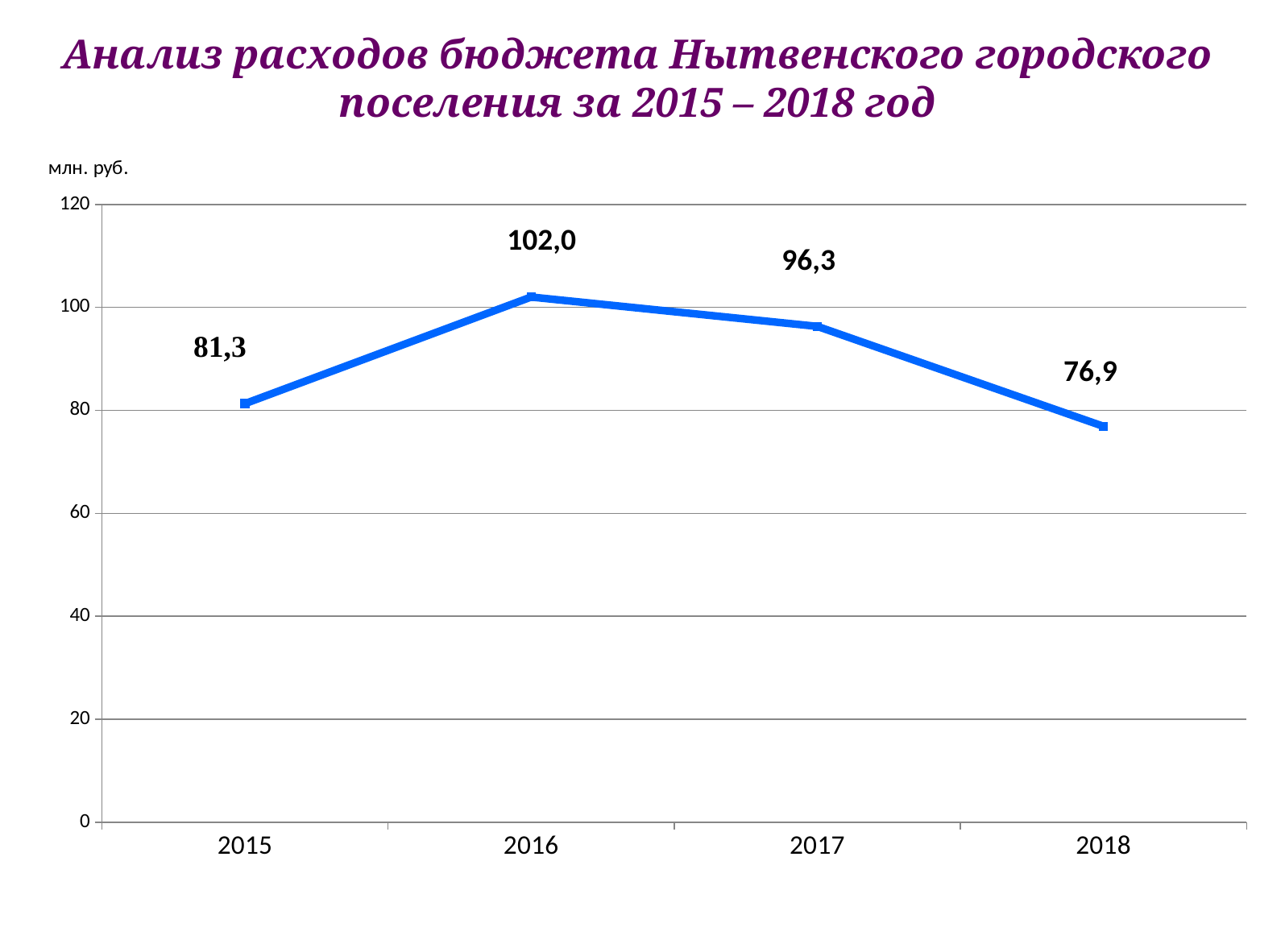
Which is larger, the value for 2015 or the value for 2017? 2017 What is the difference between the values for 2015 and 2018? 4,4 What is the difference between the values for 2016 and 2017? 5,7 How many years are plotted on the chart? 4 What is the value plotted for 2015? 81,3 Which year has the lowest expenditure value? 2018 What kind of chart is shown on the slide? line chart Is the value for 2017 greater or less than 100? less What unit is shown on the vertical axis of the chart? млн. руб. What is the budget expenditure value for 2016? 102,0 Which year has the highest expenditure value? 2016 What is the value plotted for 2018? 76,9